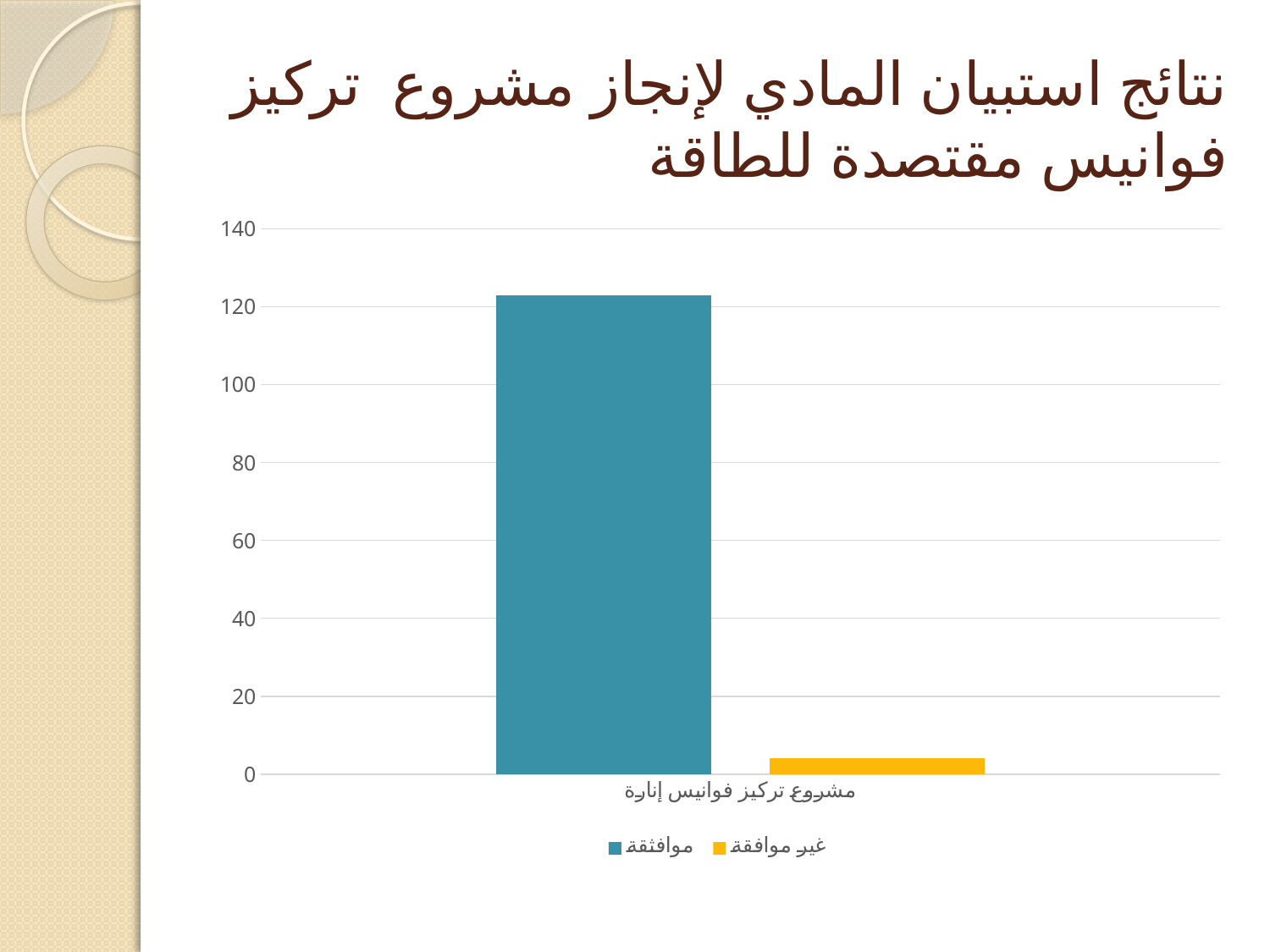
What colour is the bar for the series غير موافقة? yellow Is the value for غير موافقة greater or less than 20? less How many categories are shown on the x axis? 1 How many series does the legend list? 2 What kind of chart is shown on the slide? bar chart Which series has the higher value for مشروع تركيز فوانيس إنارة: موافقة or غير موافقة? موافقة What is the highest value shown on the vertical axis? 140 Is the value for موافقة greater or less than 100? greater Which series has the highest bar? موافقة Is the value for موافقة greater or less than 140? less Which series has the lowest bar? غير موافقة